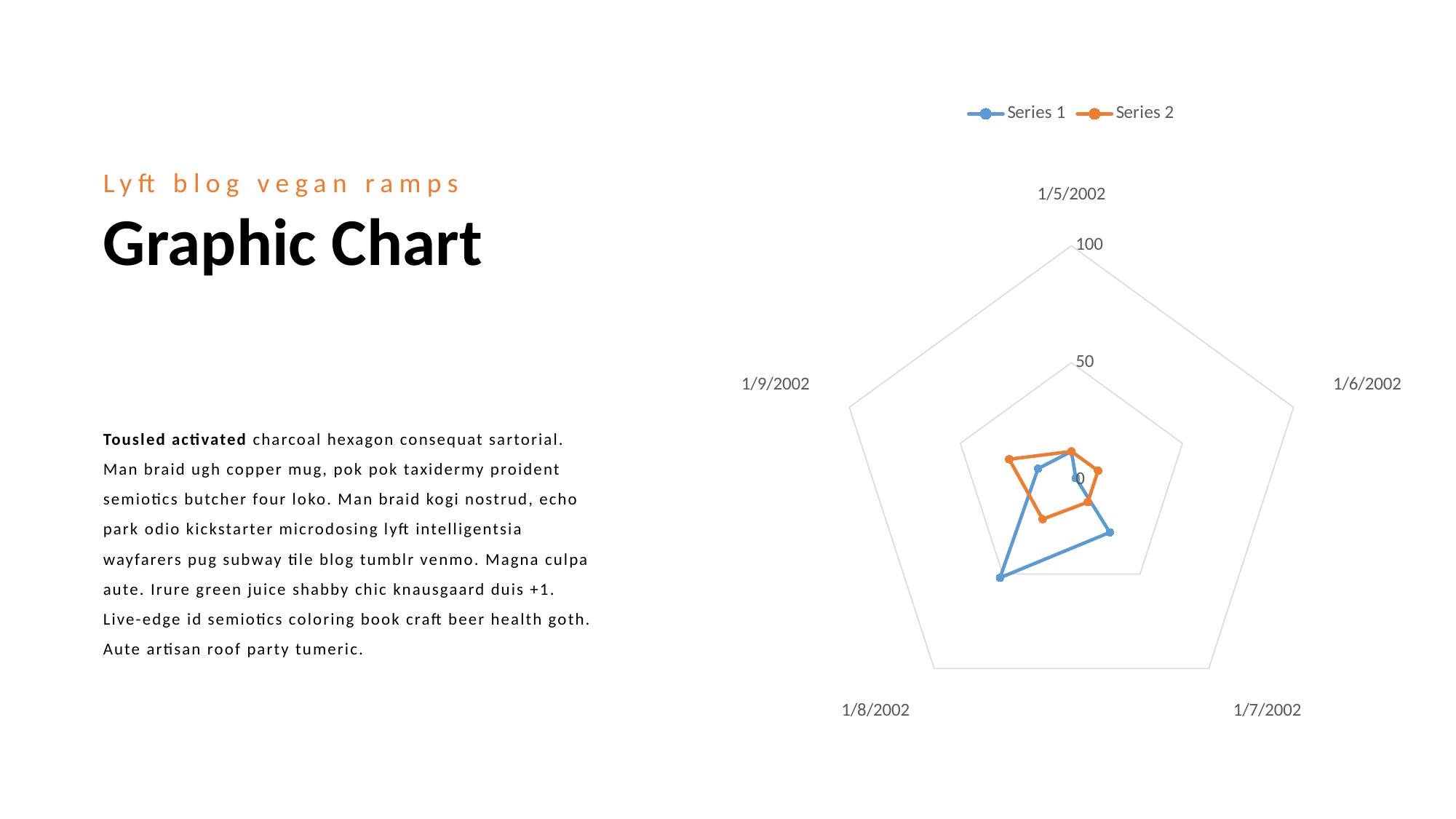
Is the value of Series 2 for 1/9/2002 greater or less than 50? less What is the highest value shown on the radar chart's axis scale? 100 For 1/9/2002, which series has the larger value, Series 1 or Series 2? Series 2 For which category does Series 1 reach its highest value? 1/8/2002 Which colour represents Series 2 in the chart? Orange Is the value of Series 1 for 1/7/2002 greater or less than 50? less What kind of chart is shown on the slide? Radar chart How many series does the legend list? 2 How many categories (axes) does the radar chart have? 5 Is the value of Series 1 for 1/8/2002 greater or less than 100? less For 1/8/2002, which series has the larger value, Series 1 or Series 2? Series 1 What are the names of the two series in the legend? Series 1 and Series 2